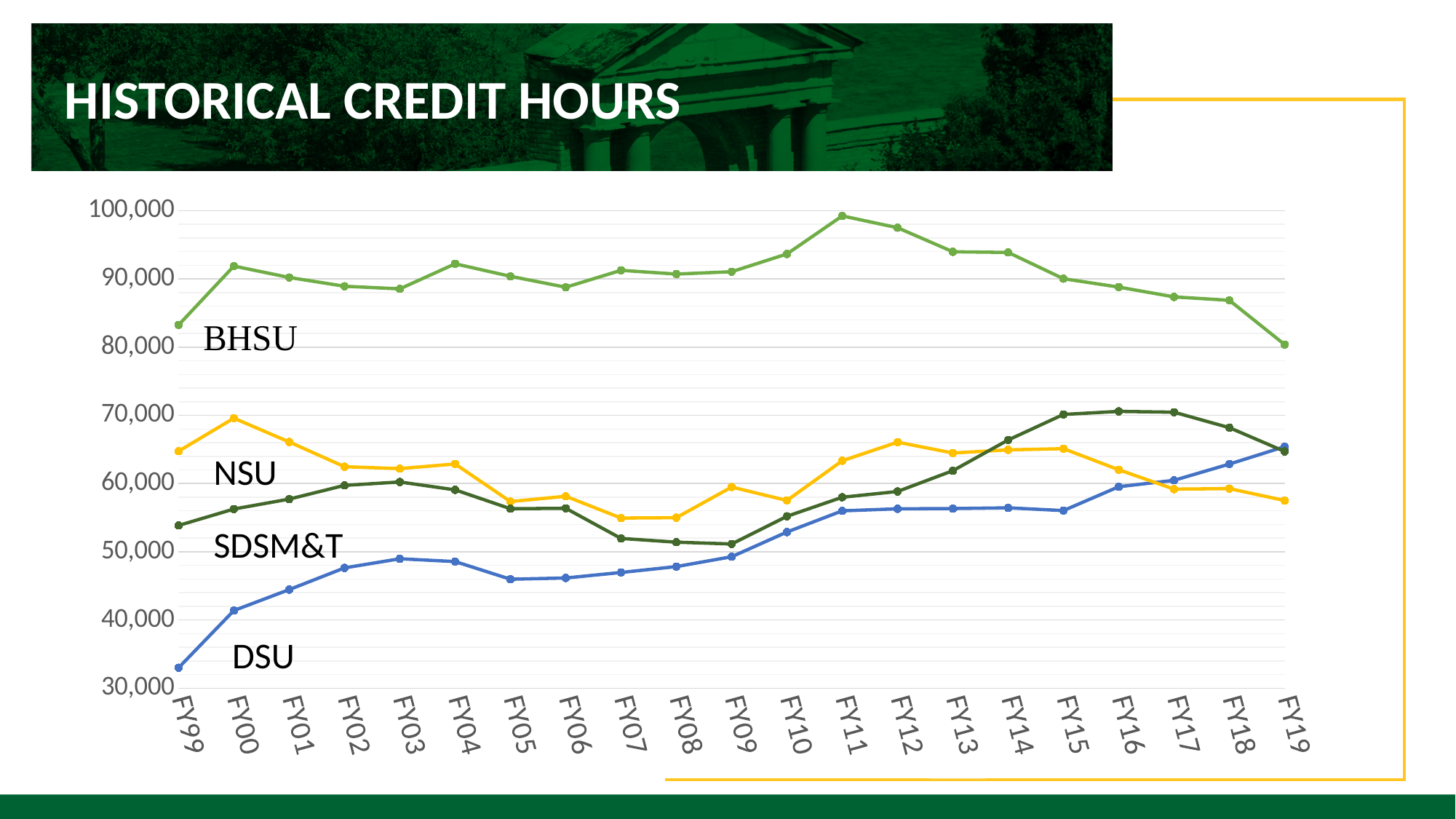
How many institutions (series) are plotted on the chart? 4 Is the value for BHSU in FY11 greater or less than 90,000? greater What is the title of the chart? HISTORICAL CREDIT HOURS In FY15, which is larger, the value for SDSM&T or the value for NSU? SDSM&T Which institution has the highest credit hours across all fiscal years shown? BHSU What kind of chart is shown on the slide? line chart Do the credit hours for BHSU rise or fall from FY11 to FY19? fall Is the value for SDSM&T in FY09 greater or less than 60,000? less Is the value for DSU in FY99 greater or less than 40,000? less How many fiscal years are plotted along the x axis? 21 Which institution has the lowest credit hours in FY99? DSU In which fiscal year does BHSU reach its highest credit hours? FY11